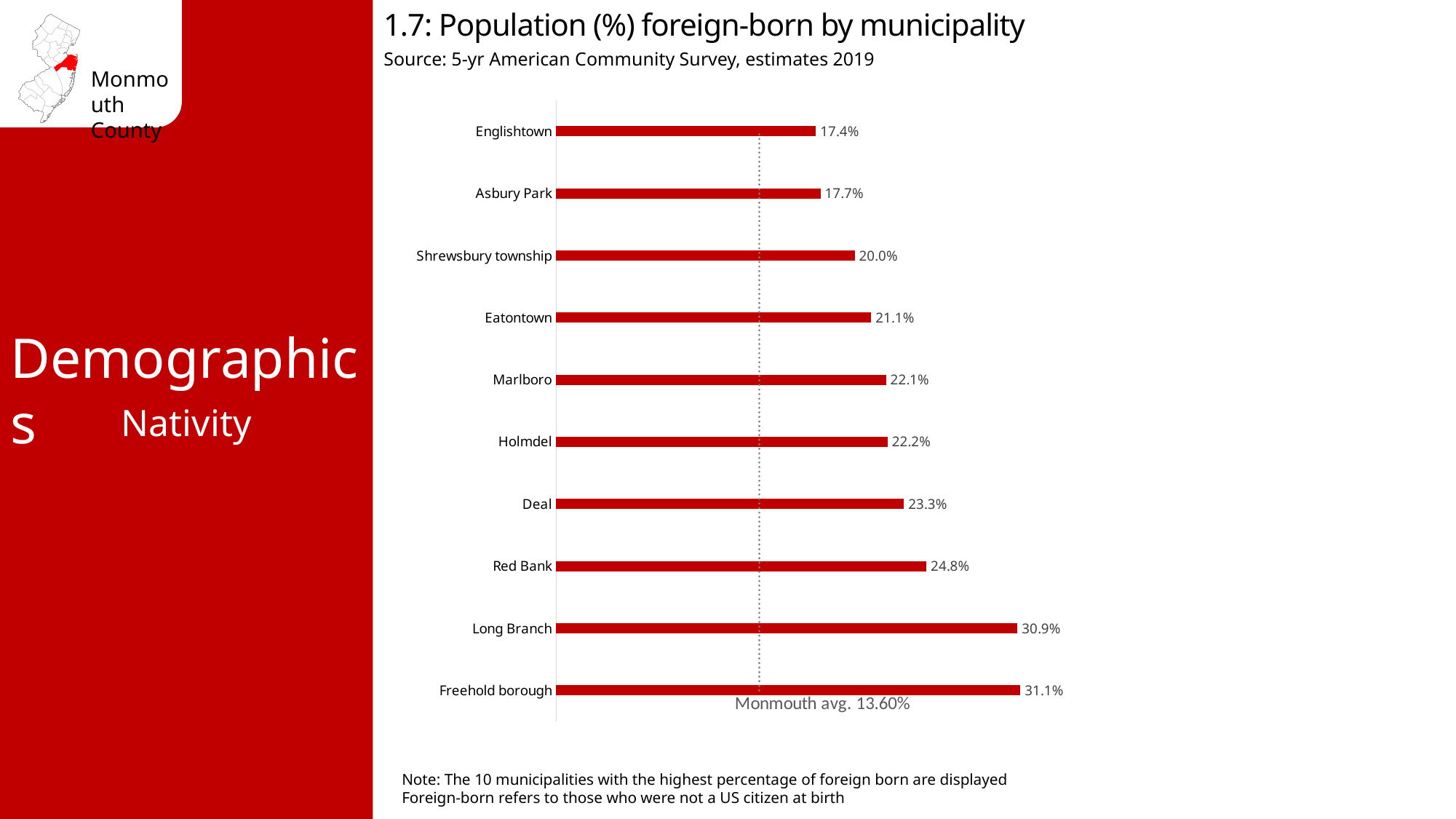
What is the foreign-born population percentage for Englishtown? 17.4% What is the Monmouth County average foreign-born percentage indicated by the dotted line? 13.60% What is the difference in foreign-born percentage between Freehold borough and Englishtown? 13.7% What is the foreign-born population percentage for Red Bank? 24.8% What is the difference in foreign-born percentage between Long Branch and Deal? 7.6% Which municipality has the highest foreign-born population percentage? Freehold borough What is the foreign-born population percentage for Shrewsbury township? 20.0% Which has a higher foreign-born percentage, Marlboro or Red Bank? Red Bank What is the source of the data shown in the chart? 5-yr American Community Survey, estimates 2019 Which municipality has the lowest foreign-born population percentage shown on the chart? Englishtown How many municipalities are shown on the chart? 10 What kind of chart is used to show the foreign-born population by municipality? Bar chart